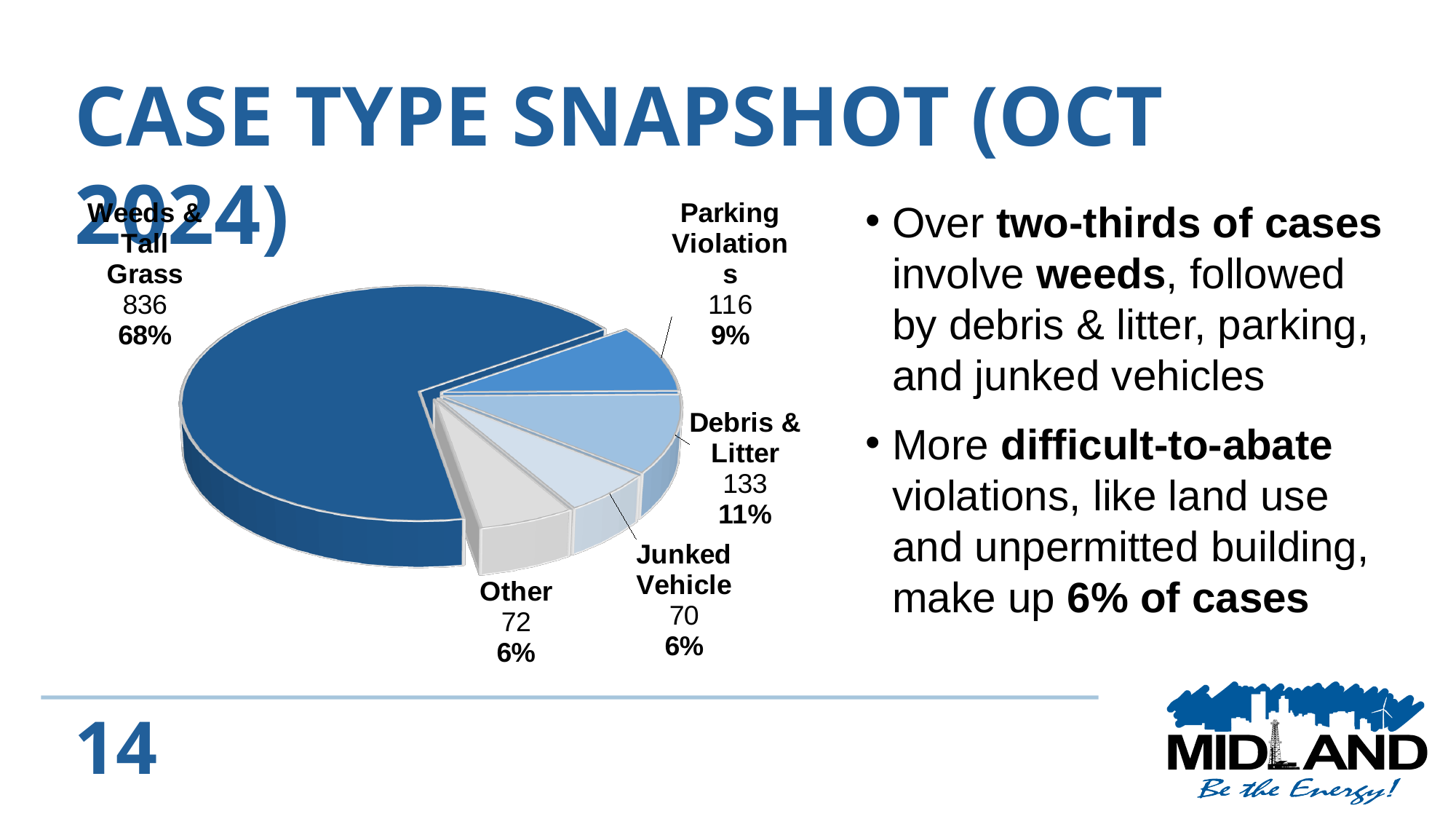
How many categories are shown in the pie chart? 5 What type of chart is shown on the slide? Pie chart Which category has the largest slice? Weeds & Tall Grass Which category has the smallest number of cases? Junked Vehicle What is the difference in cases between Weeds & Tall Grass and Debris & Litter? 703 What percentage share does Debris & Litter have? 11% How many cases are labelled for Parking Violations? 116 What is the value for Junked Vehicle? 70 Which has more cases, Other or Junked Vehicle? Other How many cases are labelled for Weeds & Tall Grass? 836 What percentage share does Weeds & Tall Grass have? 68% What is the difference in cases between Debris & Litter and Parking Violations? 17